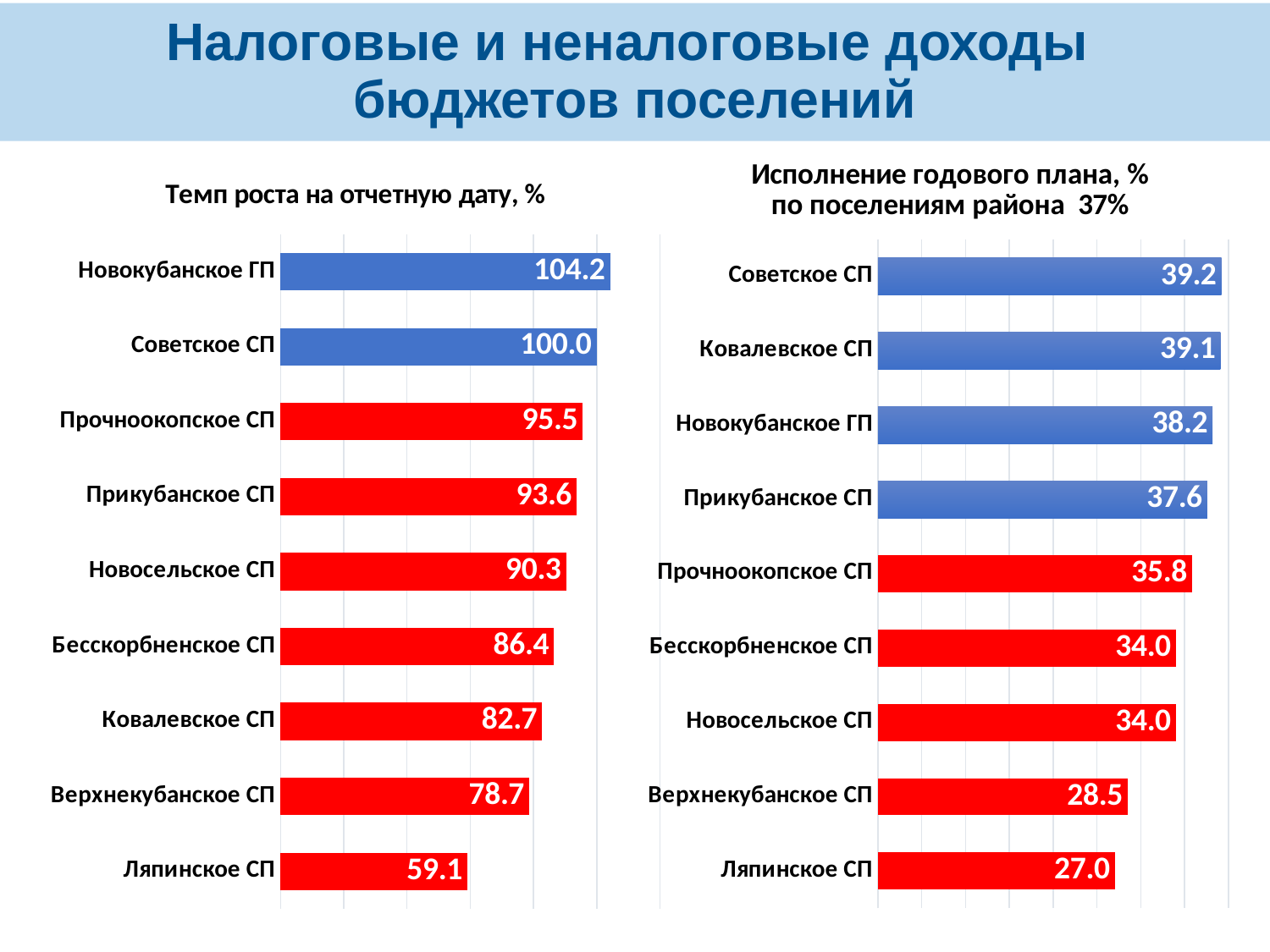
In the right chart 'Исполнение годового плана, %', what is the value for Прочноокопское СП? 35.8 In the left chart 'Темп роста на отчетную дату, %', what is the value for Новокубанское ГП? 104.2 In the right chart 'Исполнение годового плана, %', which category has the highest value? Советское СП In the right chart 'Исполнение годового плана, %', what is the district-wide value stated in the title? 37% In the left chart 'Темп роста на отчетную дату, %', what is the difference between Прочноокопское СП and Прикубанское СП? 1.9 In the left chart 'Темп роста на отчетную дату, %', what is the value for Ковалевское СП? 82.7 In the left chart 'Темп роста на отчетную дату, %', how many categories are shown? 9 In the left chart 'Темп роста на отчетную дату, %', which category has the lowest value? Ляпинское СП In the right chart 'Исполнение годового плана, %', how many categories are shown in blue? 4 In the left chart 'Темп роста на отчетную дату, %', what kind of chart is it? Bar chart In the right chart 'Исполнение годового плана, %', what is the difference between Советское СП and Ляпинское СП? 12.2 In the right chart 'Исполнение годового плана, %', which is larger: Верхнекубанское СП or Ляпинское СП? Верхнекубанское СП